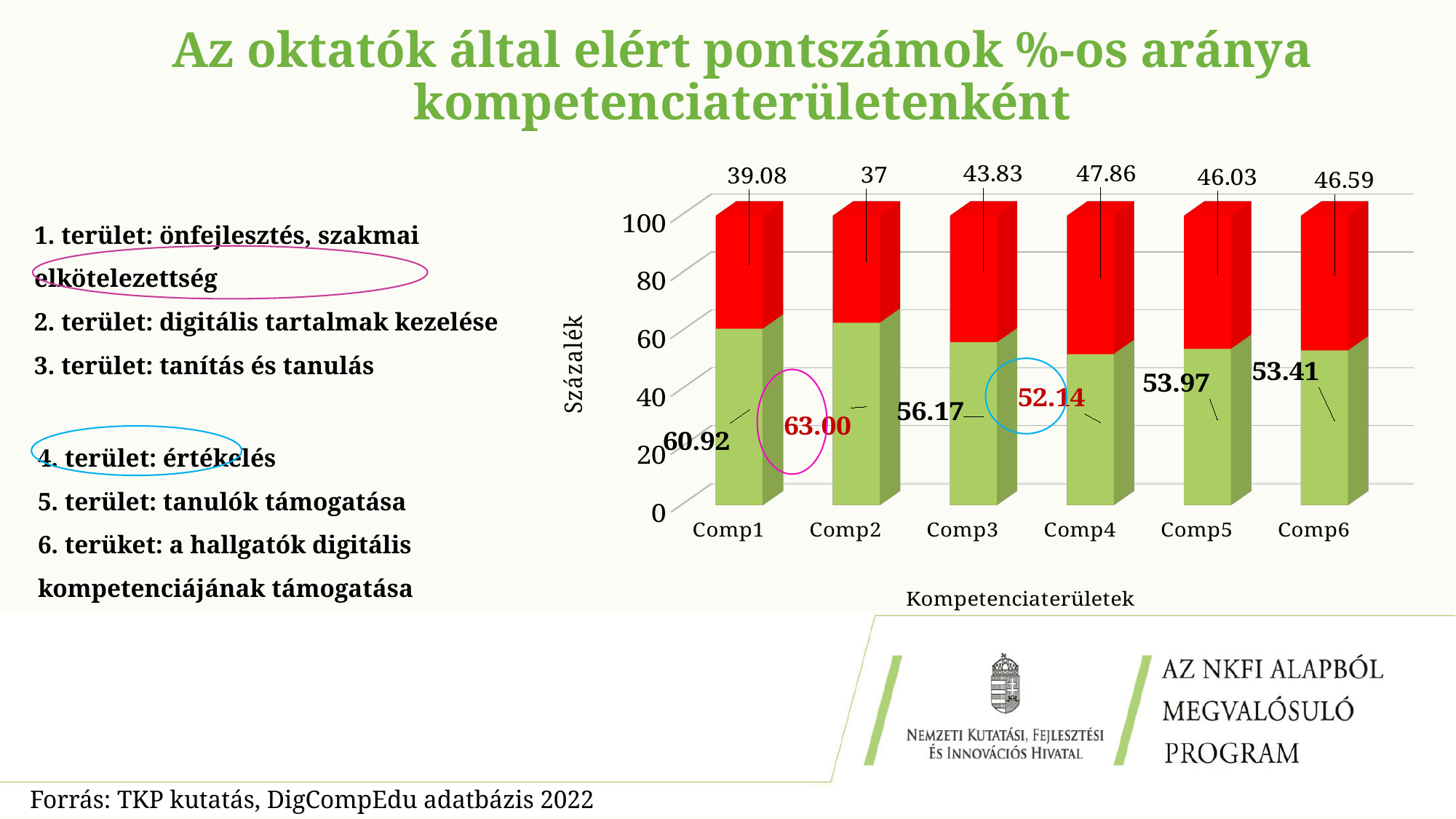
Which is larger: the red segment value for Comp3 or for Comp6? Comp6 What is the value of the red (upper) segment for Comp2? 37 How many categories are shown on the x axis? 6 What is the difference between the green segment values of Comp2 and Comp4? 10.86 Which category has the highest green (lower) segment value? Comp2 What is the value of the green (lower) segment for Comp5? 53.97 What is the label of the y axis? Százalék Which category has the highest red (upper) segment value? Comp4 What is the value of the red (upper) segment for Comp4? 47.86 What is the value of the green (lower) segment for Comp1? 60.92 What is the total of the stacked bar for Comp3? 100 Which category has the lowest green (lower) segment value? Comp4